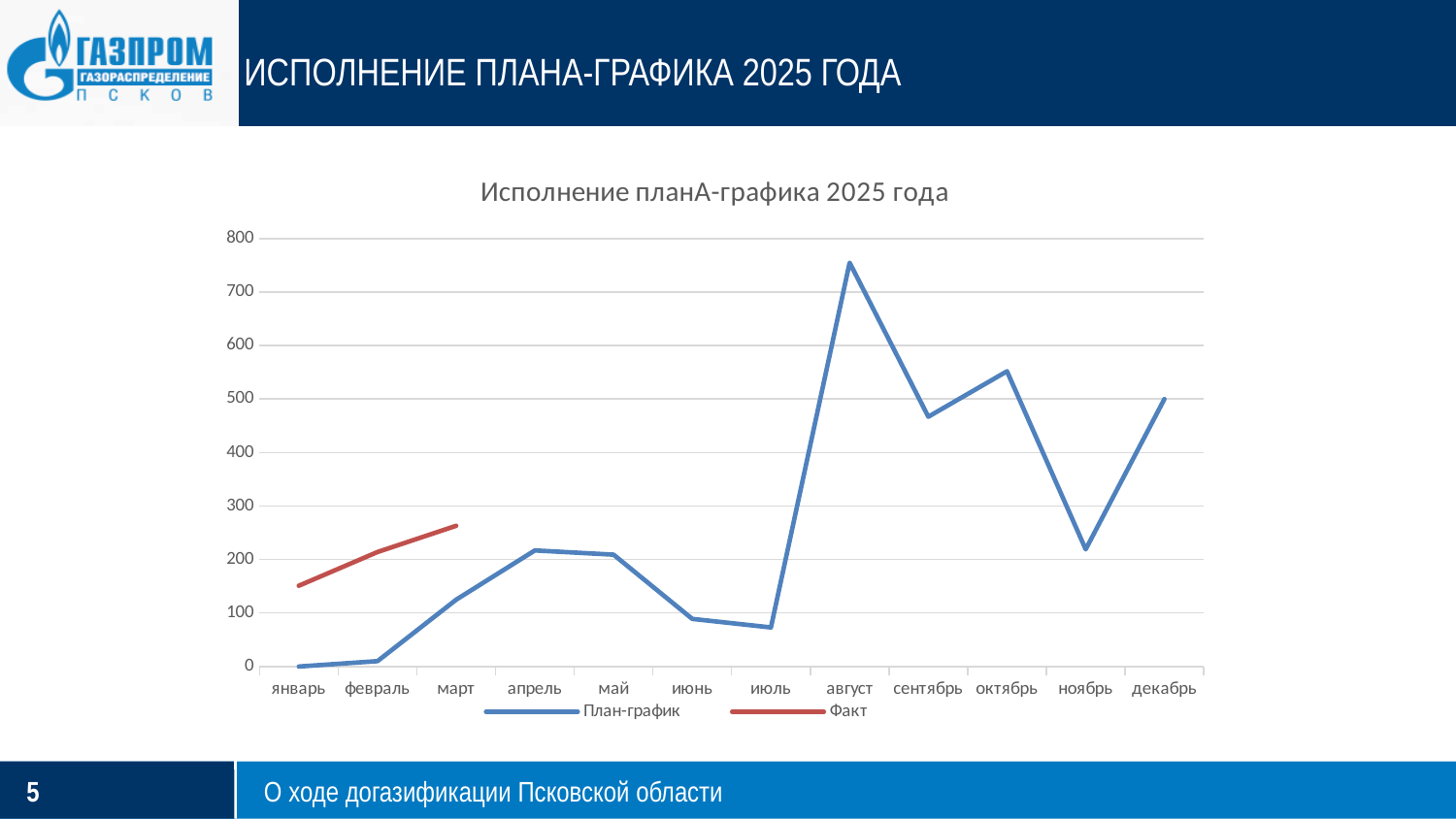
In which month is the План-график series at its lowest value? январь Which is larger in март: the План-график value or the Факт value? Факт Is the value of Факт for март greater or less than 200? greater What kind of chart is shown on the slide? line chart Is the value of План-график for август greater or less than 700? greater How many months are shown on the x axis? 12 Which series is drawn in red? Факт Is the value of План-график for июль greater or less than 100? less In which month does the План-график series reach its highest value? август How many series does the legend list? 2 Does the Факт series rise or fall from январь to март? rise